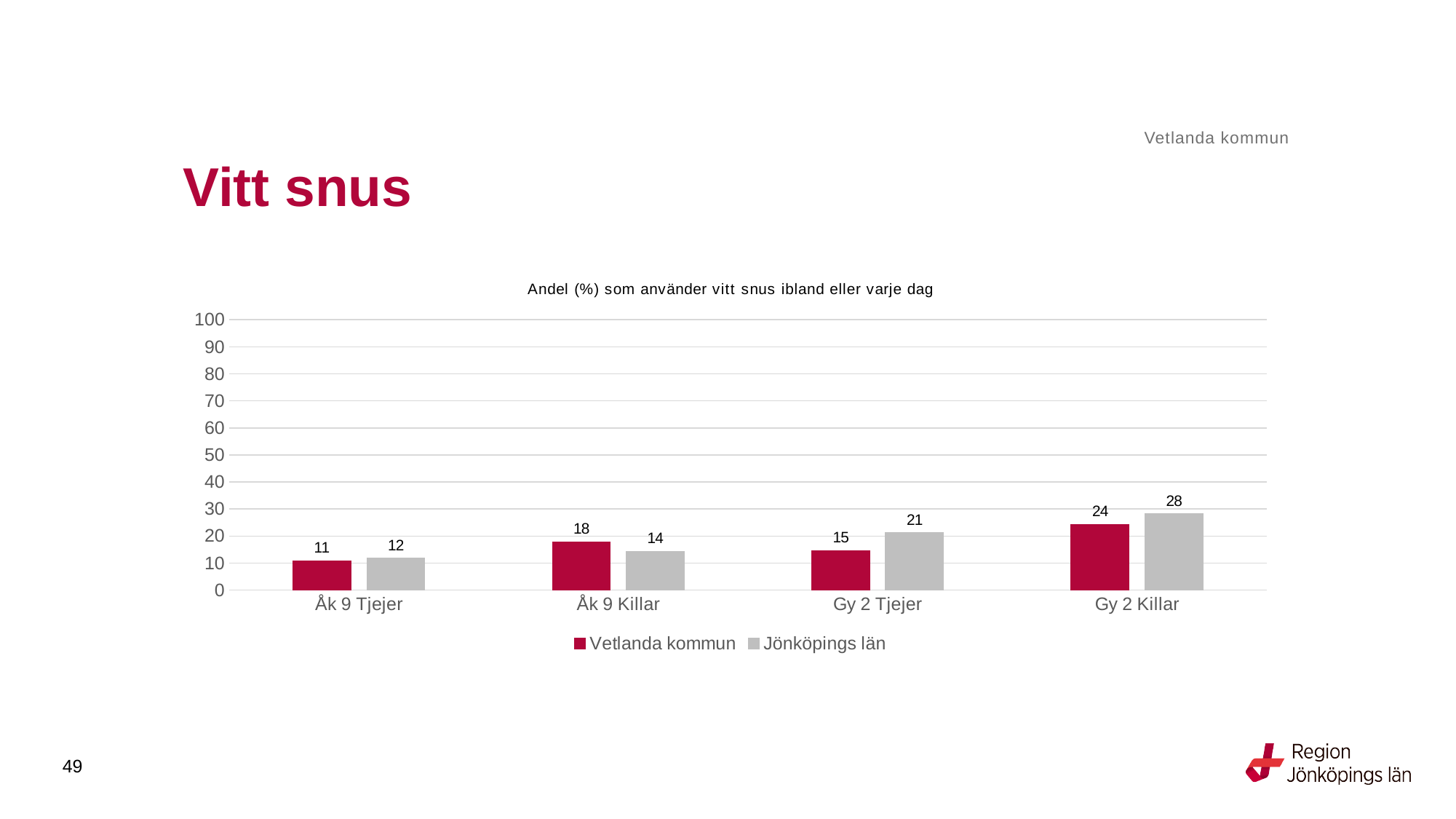
Which category has the lowest value for Jönköpings län? Åk 9 Tjejer Which category has the highest value for Vetlanda kommun? Gy 2 Killar In the Åk 9 Killar category, which series has the larger value, Vetlanda kommun or Jönköpings län? Vetlanda kommun What is the value for Vetlanda kommun in the Åk 9 Tjejer category? 11 How many series does the legend list? 2 What is the value for Jönköpings län in the Gy 2 Killar category? 28 What is the difference between Jönköpings län and Vetlanda kommun in the Gy 2 Tjejer category? 6 What is the title of the chart? Andel (%) som använder vitt snus ibland eller varje dag What is the value for Jönköpings län in the Gy 2 Tjejer category? 21 Is the value for Jönköpings län in the Gy 2 Killar category greater or less than 20? greater How many categories are shown on the x axis? 4 What kind of chart is shown on the slide? Bar chart